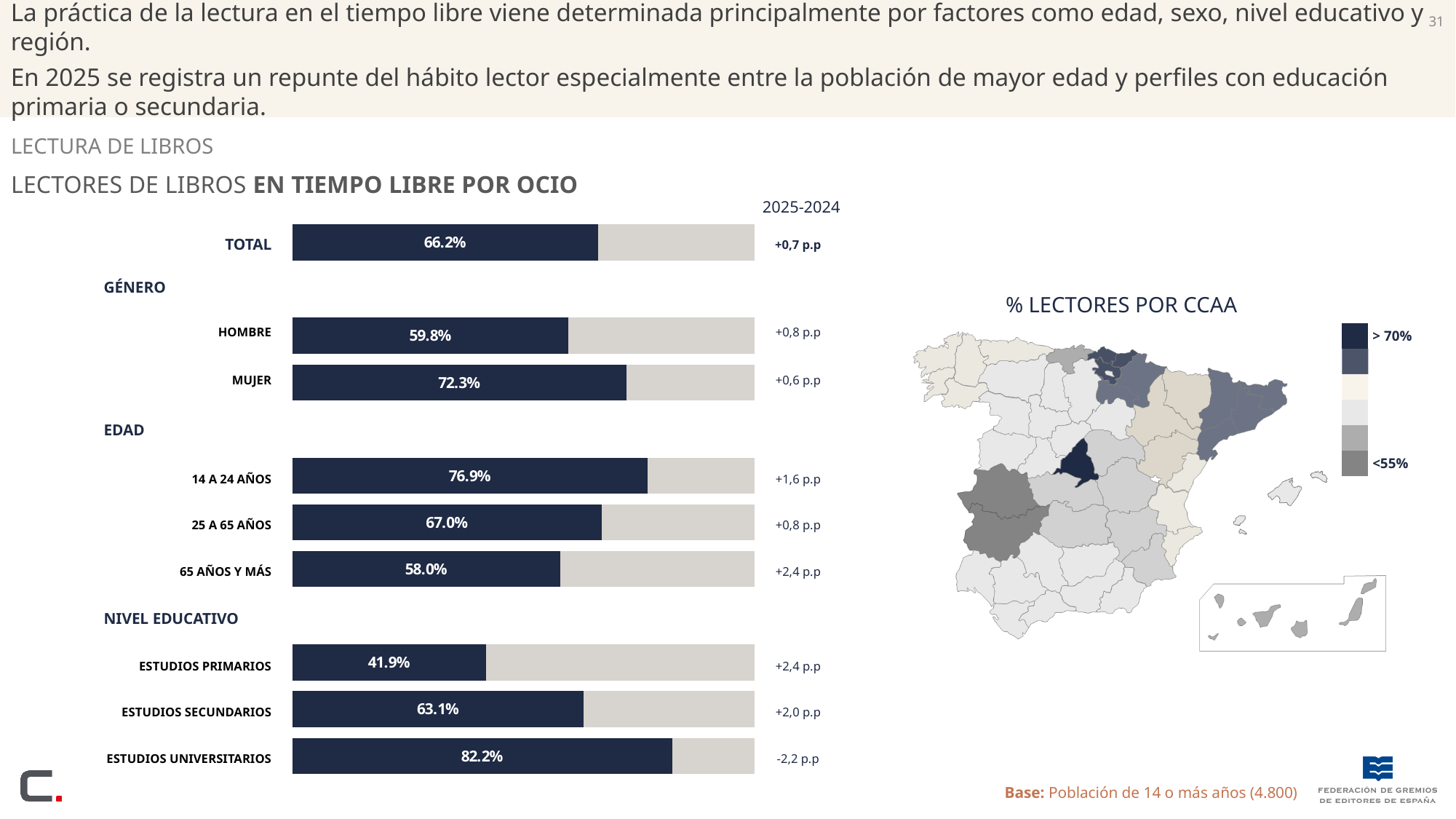
In the bar chart 'Lectores de libros en tiempo libre por ocio', what is the difference in percentage points between MUJER and HOMBRE? 12.5 In the bar chart 'Lectores de libros en tiempo libre por ocio', how many bars are plotted? 9 In the bar chart 'Lectores de libros en tiempo libre por ocio', which is larger, the value for 25 A 65 AÑOS or the value for ESTUDIOS SECUNDARIOS? 25 A 65 AÑOS In the bar chart 'Lectores de libros en tiempo libre por ocio', which category has the highest value? ESTUDIOS UNIVERSITARIOS In the bar chart 'Lectores de libros en tiempo libre por ocio', which category has the lowest value? ESTUDIOS PRIMARIOS In the bar chart 'Lectores de libros en tiempo libre por ocio', what is the difference in percentage points between 14 A 24 AÑOS and 65 AÑOS Y MÁS? 18.9 What kind of chart is 'Lectores de libros en tiempo libre por ocio'? Bar chart In the bar chart 'Lectores de libros en tiempo libre por ocio', what is the value for ESTUDIOS PRIMARIOS? 41.9% In the bar chart 'Lectores de libros en tiempo libre por ocio', what is the value for TOTAL? 66.2% In the bar chart 'Lectores de libros en tiempo libre por ocio', which category is the only one with a negative 2025-2024 change? ESTUDIOS UNIVERSITARIOS In the bar chart 'Lectores de libros en tiempo libre por ocio', what is the value for MUJER? 72.3% In the bar chart 'Lectores de libros en tiempo libre por ocio', what is the 2025-2024 change shown for 65 AÑOS Y MÁS? +2,4 p.p